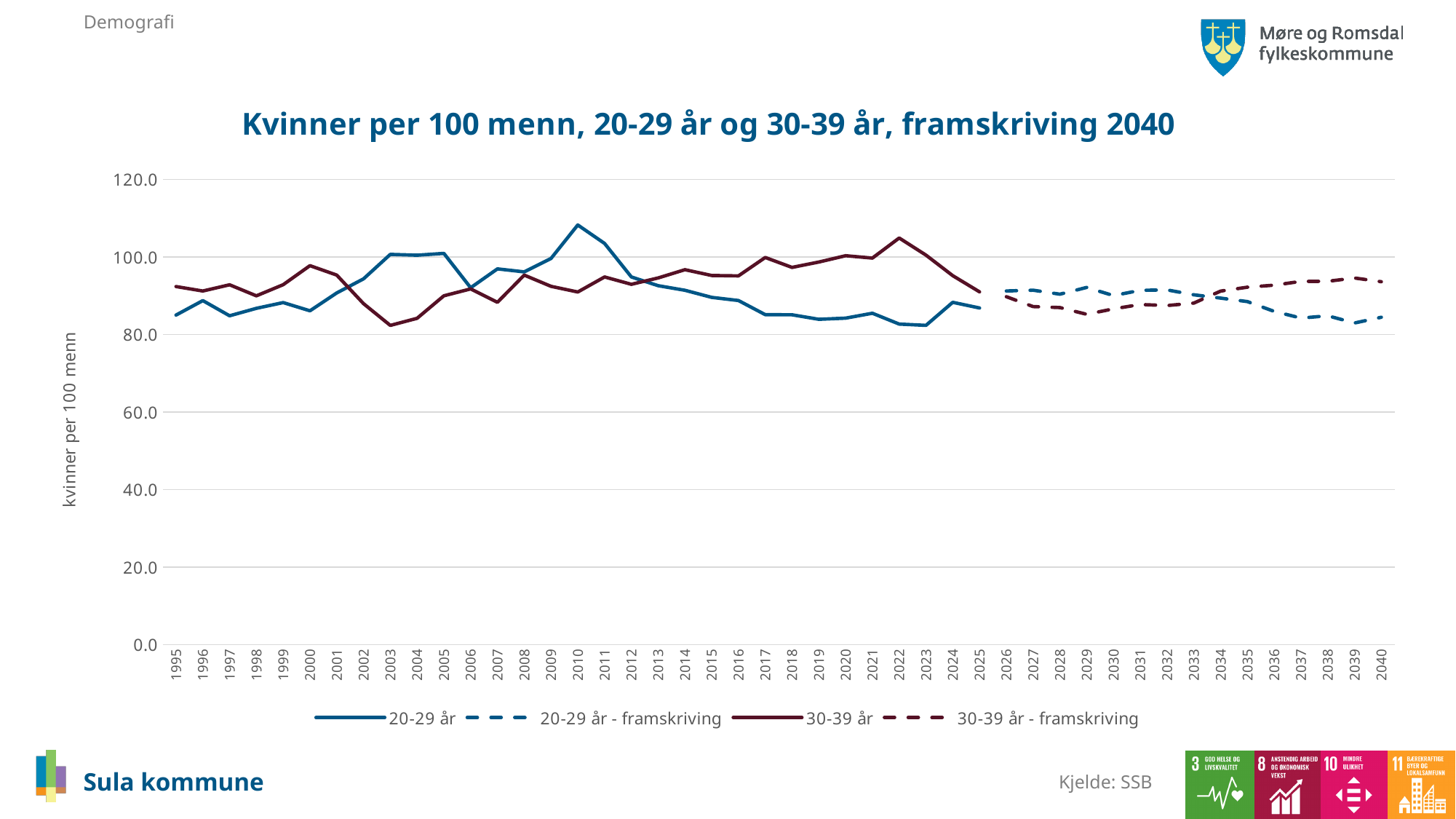
Is the value for 20-29 år in 2010 greater or less than 100? greater What is the label on the vertical axis? kvinner per 100 menn In 2022, which series has the larger value, 20-29 år or 30-39 år? 30-39 år What kind of chart is shown on the slide? line chart In which year does the 30-39 år series reach its highest value? 2022 In which year does the 30-39 år series reach its lowest value? 2003 In which year does the 20-29 år series reach its highest value? 2010 How many series does the legend list? 4 Does the 30-39 år - framskriving series generally rise or fall from 2026 to 2040? rise In 2003, which series has the larger value, 20-29 år or 30-39 år? 20-29 år Is the value for 20-29 år in 2023 greater or less than 100? less Is the value for 30-39 år in 2003 greater or less than 100? less